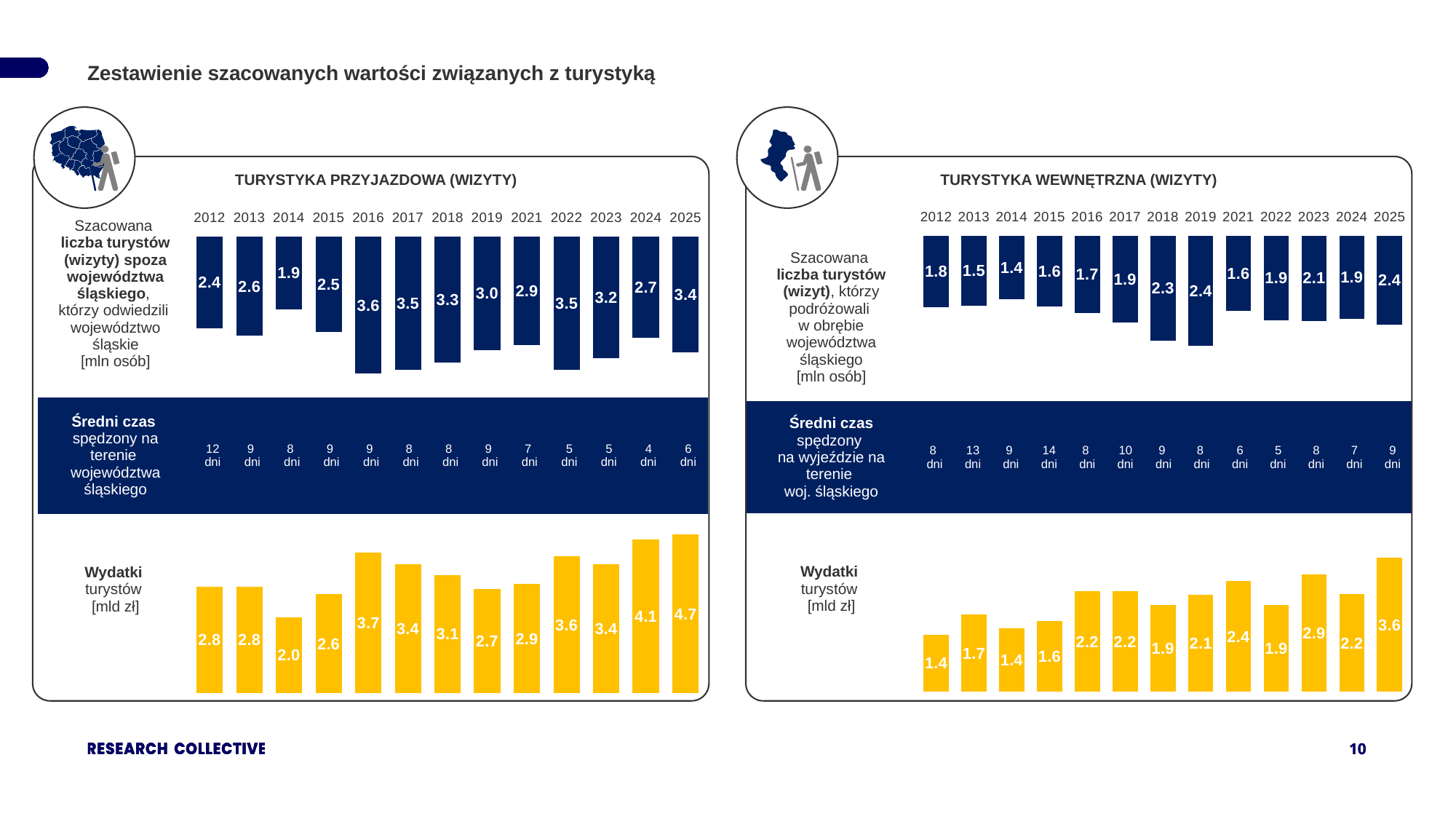
In the TURYSTYKA WEWNĘTRZNA (WIZYTY) panel, is the estimated number of tourists (mln osób) larger in 2019 or in 2021? 2019 What colour are the bars of the tourist expenditure (Wydatki turystów) charts on the slide? Yellow In the TURYSTYKA PRZYJAZDOWA (WIZYTY) panel, which year has the highest tourist expenditure (Wydatki turystów, mld zł)? 2025 How many years are shown on the x axis of the tourist count chart in the TURYSTYKA PRZYJAZDOWA (WIZYTY) panel? 13 In the TURYSTYKA PRZYJAZDOWA (WIZYTY) panel, which year has the lowest estimated number of tourists (mln osób)? 2014 In the TURYSTYKA WEWNĘTRZNA (WIZYTY) panel, what is the tourist expenditure (mld zł) for 2025? 3.6 In the TURYSTYKA PRZYJAZDOWA (WIZYTY) panel, what is the estimated number of tourists (mln osób) for 2025? 3.4 In the TURYSTYKA PRZYJAZDOWA (WIZYTY) panel, what is the estimated number of tourists (mln osób) for 2016? 3.6 In the TURYSTYKA PRZYJAZDOWA (WIZYTY) panel, what is the difference in tourist expenditure (mld zł) between 2025 and 2024? 0.6 In the TURYSTYKA WEWNĘTRZNA (WIZYTY) panel, what is the difference in the estimated number of tourists (mln osób) between 2025 and 2012? 0.6 What type of chart is used to show tourist expenditure (Wydatki turystów) in the TURYSTYKA WEWNĘTRZNA (WIZYTY) panel? Bar chart In the TURYSTYKA WEWNĘTRZNA (WIZYTY) panel, which year has the lowest tourist expenditure (mld zł)? 2012 and 2014